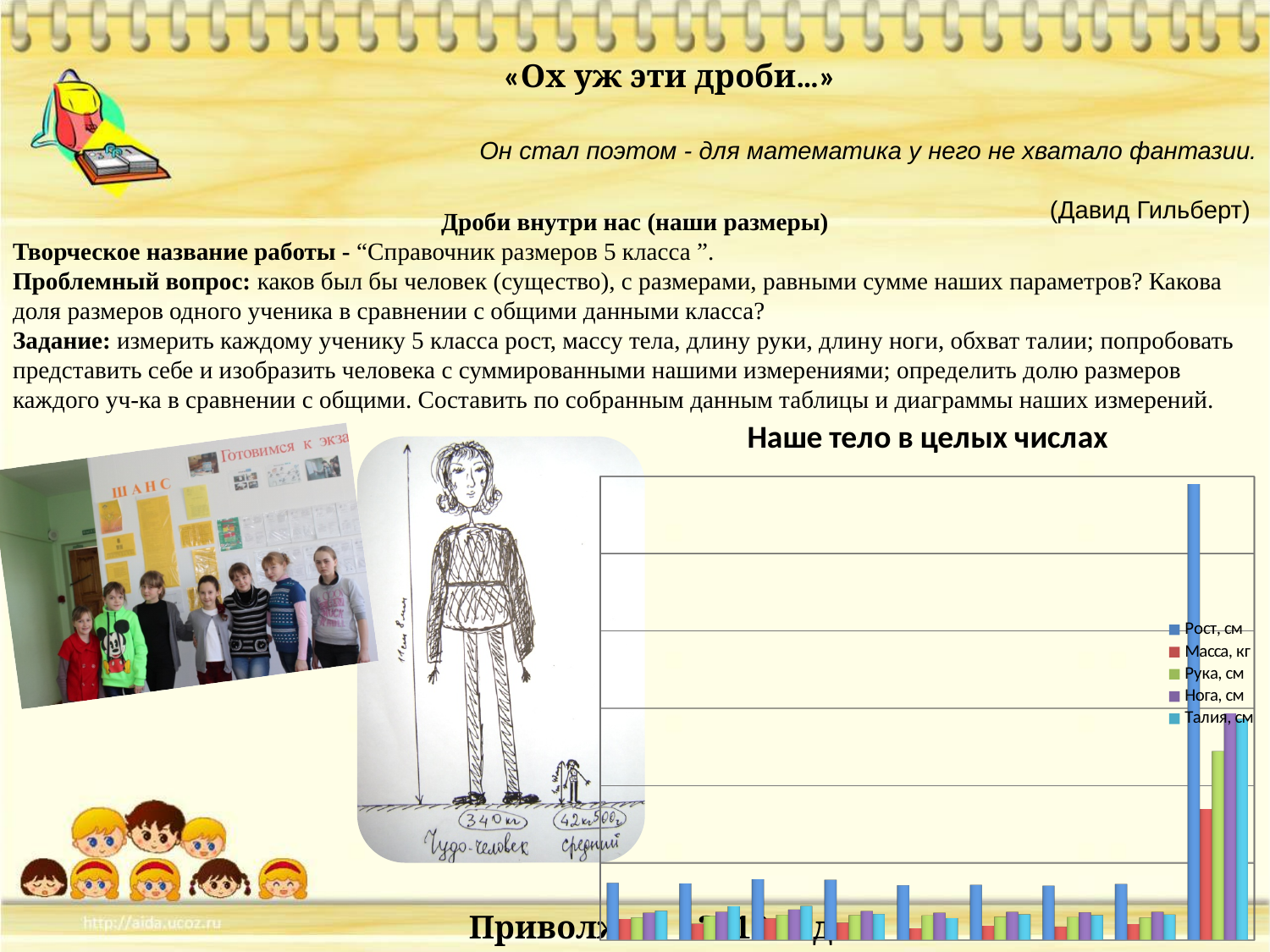
How many groups of bars are plotted in the chart? 9 What is the title of the chart on the slide? Наше тело в целых числах Which series has the tallest bar in the chart? Рост, см What kind of chart is shown under the heading "Наше тело в целых числах"? bar chart In the rightmost group of bars, which series has the shortest bar? Масса, кг In the rightmost group of bars, which is larger: Рост, см or Масса, кг? Рост, см Which series is listed first in the legend of the chart? Рост, см How many series does the legend of the "Наше тело в целых числах" chart list? 5 In the rightmost group of bars, which is larger: Нога, см or Масса, кг? Нога, см Which group of bars is the tallest in the chart: the leftmost or the rightmost? the rightmost